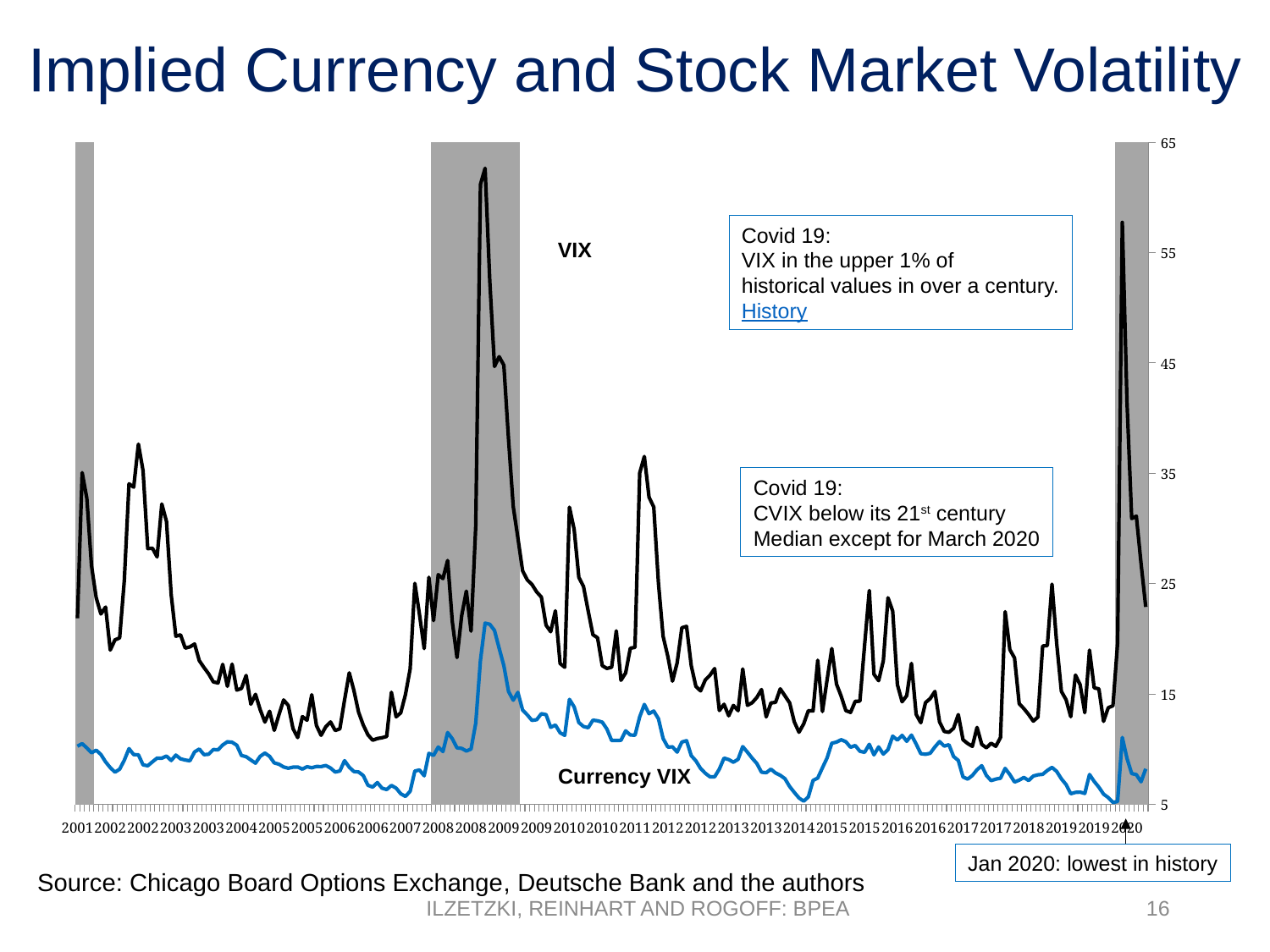
What colour is the Currency VIX line? Blue Is the peak value of the VIX series in 2008 greater or less than 55? greater What is the title of the slide containing the chart? Implied Currency and Stock Market Volatility Which series is higher in 2011, VIX or Currency VIX? VIX Which series reaches the highest value on the chart, VIX or Currency VIX? VIX Does the VIX series rise or fall from its 2008 peak to 2013? Fall Is the peak value of the VIX series in 2020 greater or less than 45? greater What is the highest value shown on the vertical axis? 65 Is the peak value of the Currency VIX series in 2008 greater or less than 25? less How many series are plotted on the chart? 2 What kind of chart is shown on the slide? Line chart